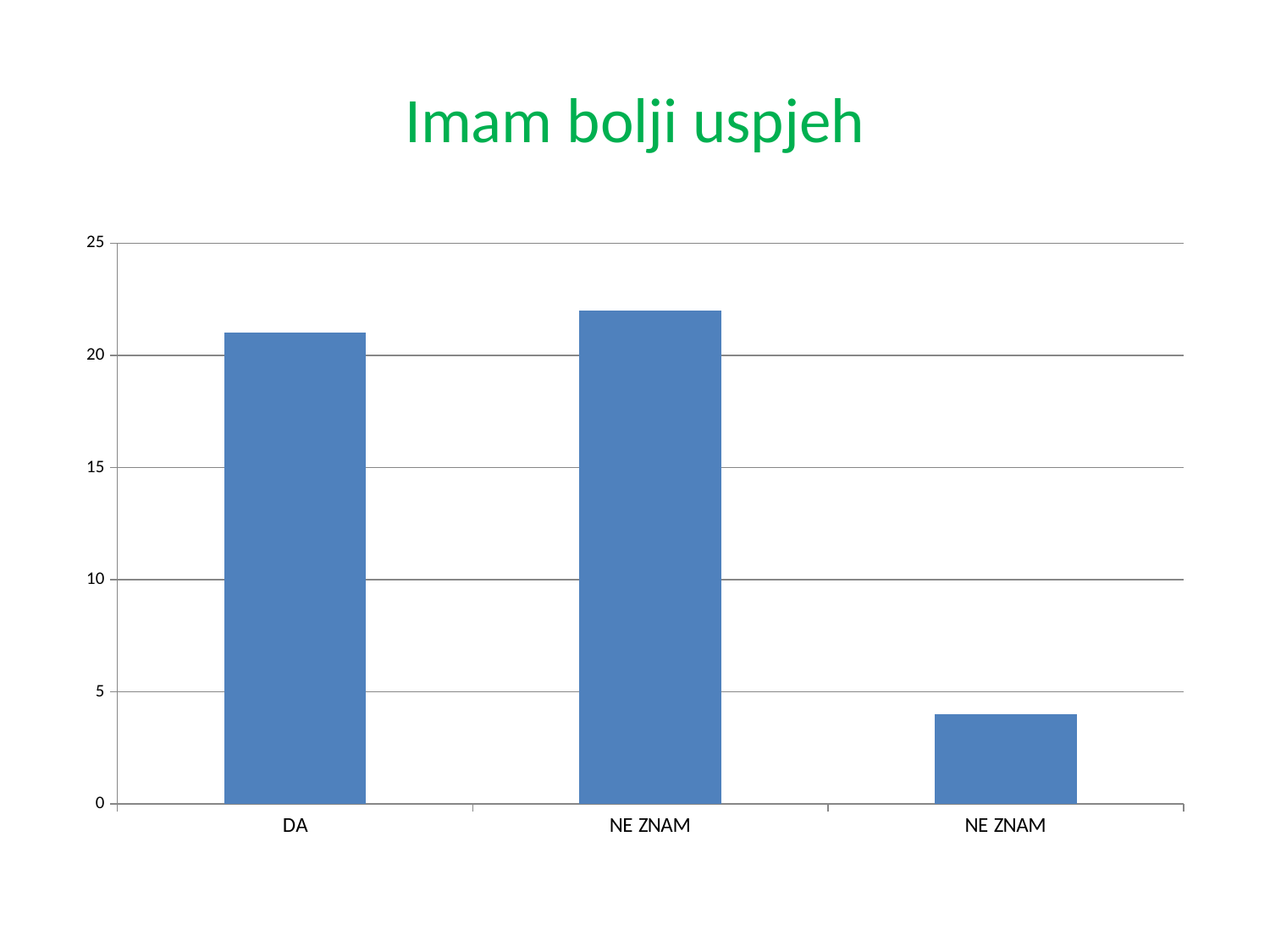
Is the value for DA greater or less than 25? less Which bar has the lowest value? the rightmost NE ZNAM bar Is the value of the rightmost bar (the second NE ZNAM) greater or less than 5? less Is the value of the middle bar (the first NE ZNAM) greater or less than 20? greater What is the title of the slide? Imam bolji uspjeh What kind of chart is shown on the slide? bar chart What is the highest value shown on the vertical axis? 25 How many bars are plotted in the chart? 3 Which is larger: the value for DA or the value of the rightmost NE ZNAM bar? DA What is the label of the first (leftmost) category on the x axis? DA